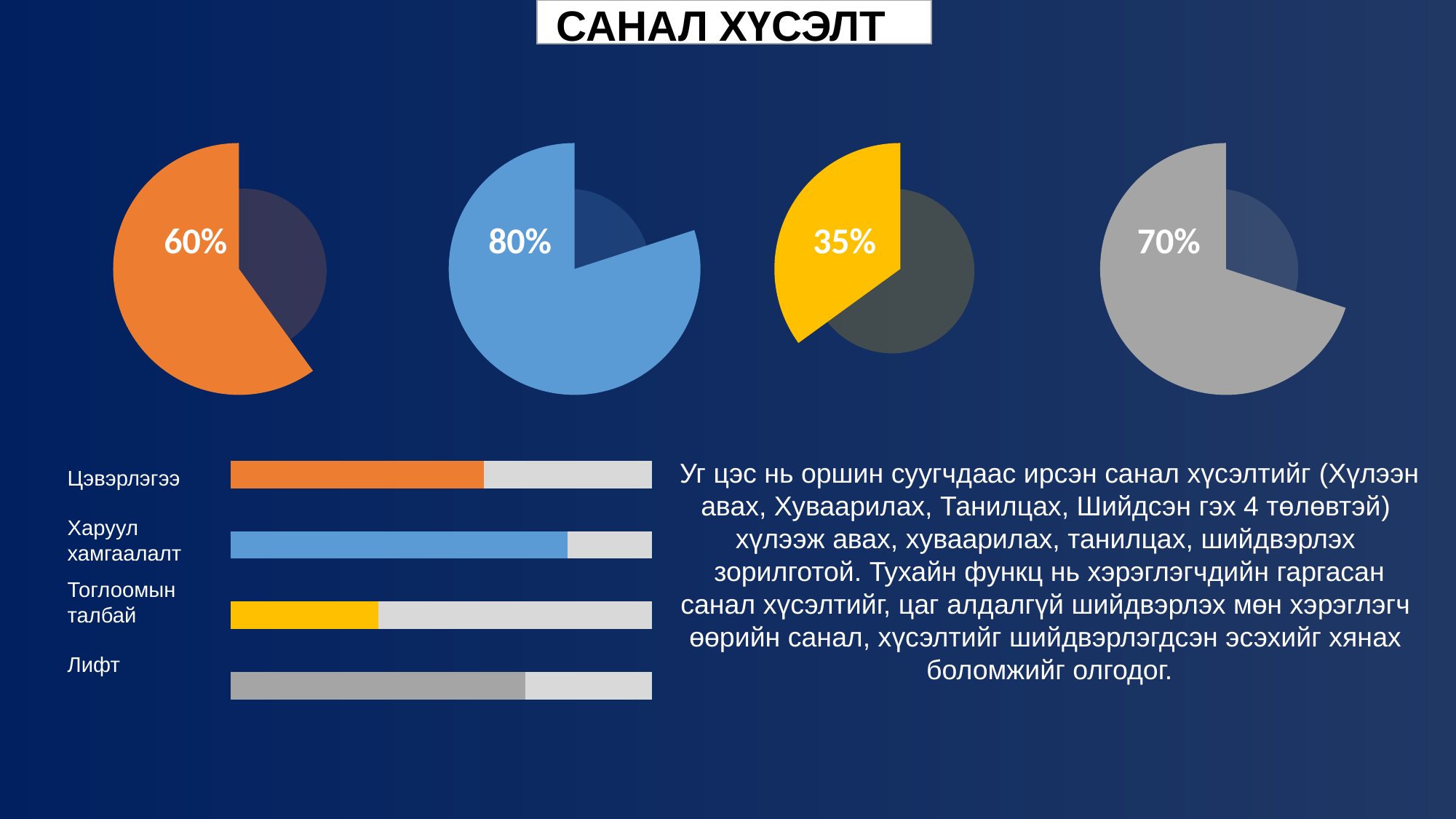
What value is shown on the yellow pie chart (third from the left)? 35% In the bar chart at the bottom left, which category has the longest bar? Харуул хамгаалалт What value is shown on the orange pie chart (the leftmost one)? 60% What value is shown on the gray pie chart (the rightmost one)? 70% In the bar chart at the bottom left, which category has the shortest bar? Тоглоомын талбай How many pie charts are shown at the top of the slide? 4 What is the difference between the value on the blue pie chart and the value on the yellow pie chart? 45% Which is larger: the value on the orange pie chart or the value on the gray pie chart? The gray pie chart (70%) Among the four pie charts at the top of the slide, which colour's chart shows the lowest percentage? Yellow (35%) Among the four pie charts at the top of the slide, which colour's chart shows the highest percentage? Blue (80%) What kind of chart is shown at the bottom left of the slide? Bar chart What value is shown on the blue pie chart (second from the left)? 80%